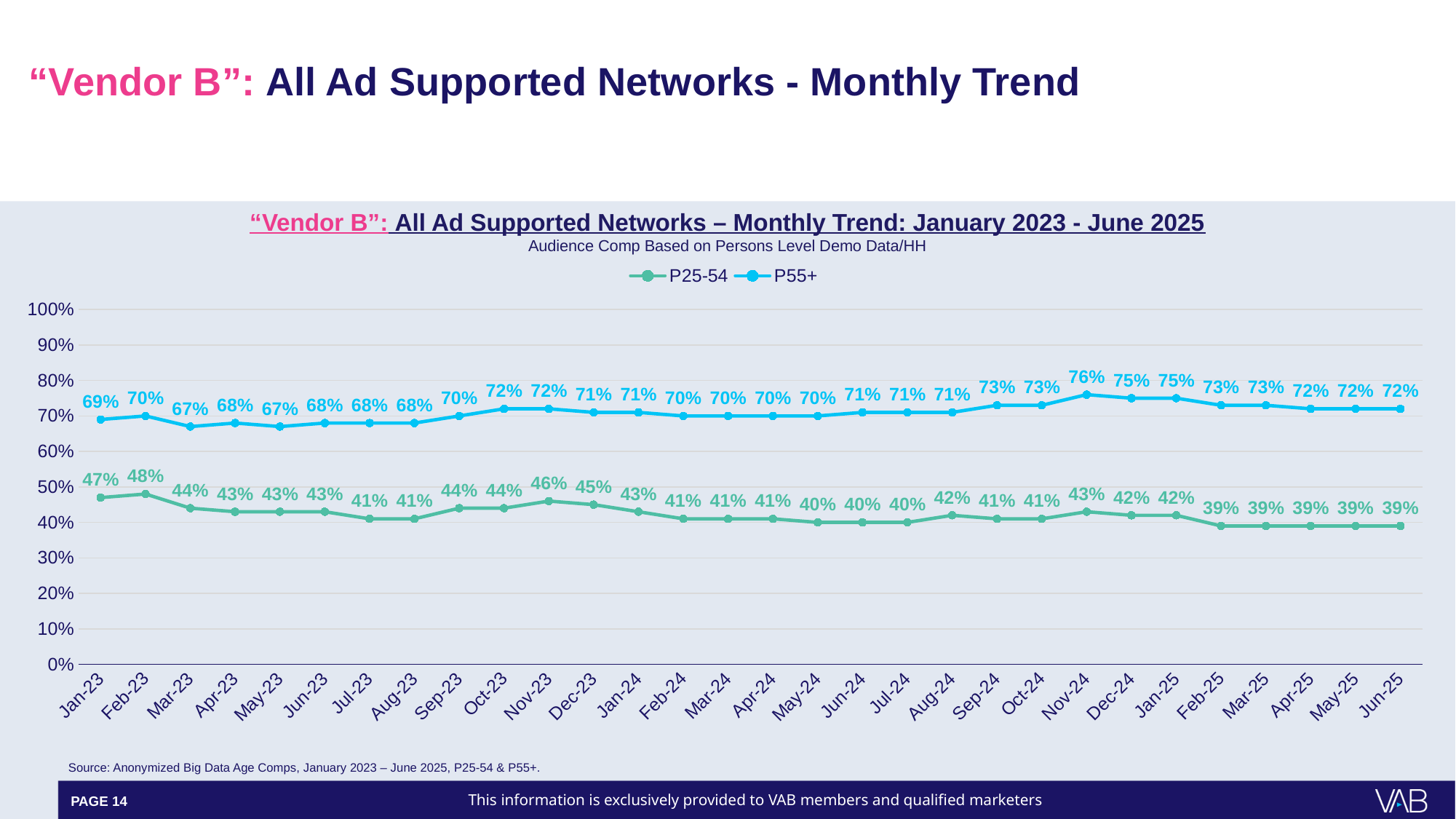
How many monthly data points are plotted for each series? 30 What is the P25-54 value for Jun-25? 39% In which month does the P55+ series reach its highest value? Nov-24 What is the P55+ value for Oct-23? 72% In which month does the P25-54 series reach its highest value? Feb-23 What is the difference between the P55+ and P25-54 values in Nov-24? 33 percentage points What is the difference between the P25-54 value in Feb-23 and in Jun-25? 9 percentage points Which is larger, the P25-54 value in Nov-23 or in Nov-24? Nov-23 How many series does the legend list? 2 What is the P55+ value for Nov-24? 76% What is the P25-54 value for Jan-23? 47% What kind of chart is shown on the slide? Line chart